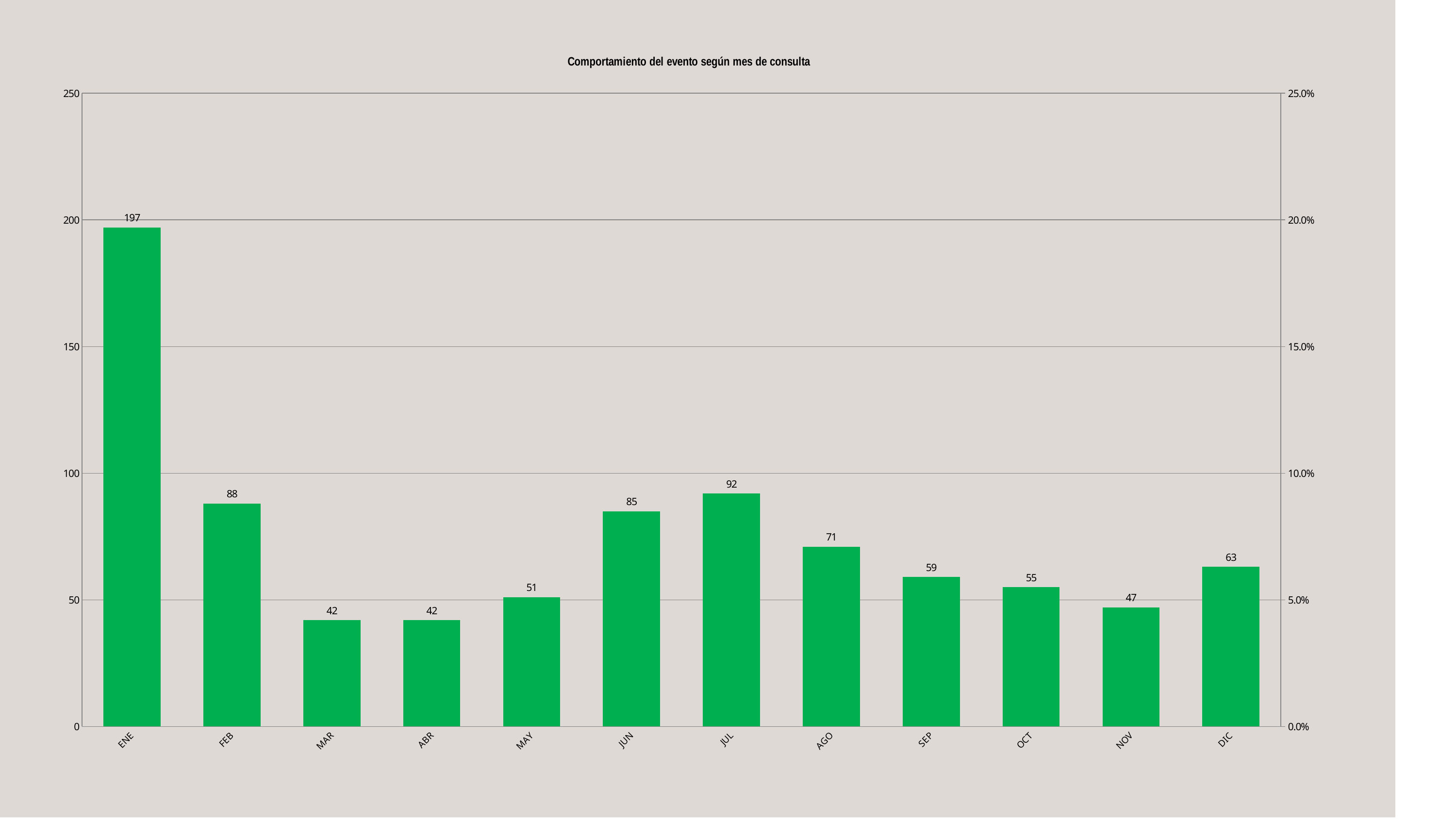
Which is larger, the value for AGO or the value for DIC? AGO What is the value for NOV? 47 Which month has the highest value? ENE What is the value for ENE? 197 What is the difference between the values for JUN and SEP? 26 How many months are shown on the x axis? 12 Do the values rise or fall from ENE to MAR? fall What is the value for JUL? 92 What kind of chart is shown on the slide? bar chart What is the difference between the values for ENE and FEB? 109 What is the title of the chart? Comportamiento del evento según mes de consulta Is the value for MAY greater or less than 100? less